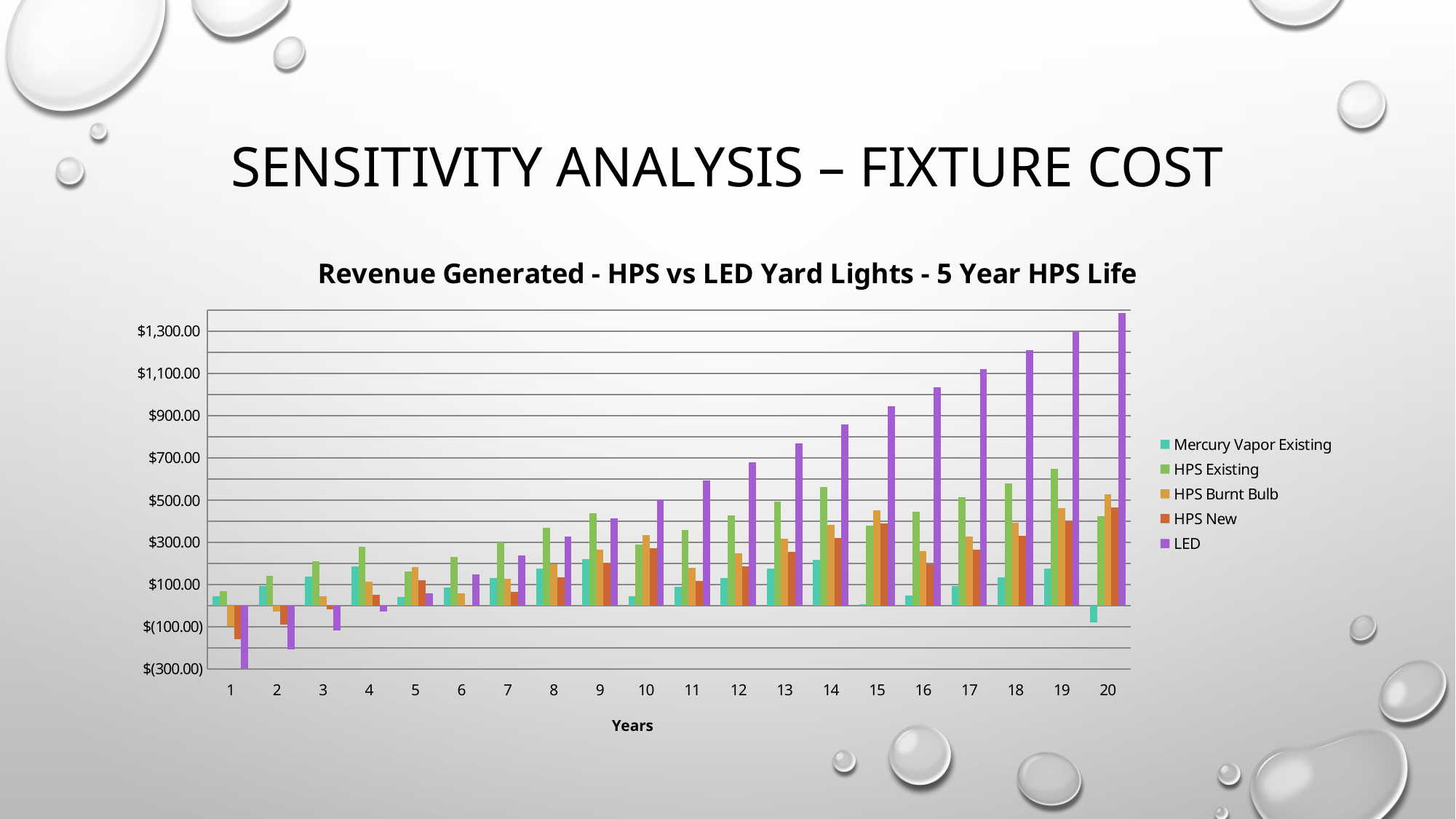
In year 4, which is larger: HPS Existing or LED? HPS Existing What is the label of the x axis? Years What is the title of the chart? Revenue Generated - HPS vs LED Yard Lights - 5 Year HPS Life Is the LED value in year 18 greater or less than $1,100.00? greater Does the LED series generally rise or fall from year 1 to year 20? rise Is the Mercury Vapor Existing value in year 20 greater or less than $100.00? less How many years are shown along the x axis? 20 What kind of chart is shown on the slide? bar chart Which series has the lowest value in year 1? LED How many series does the legend list? 5 In which year does the LED series reach its highest value? 20 Which series has the highest value in year 20? LED